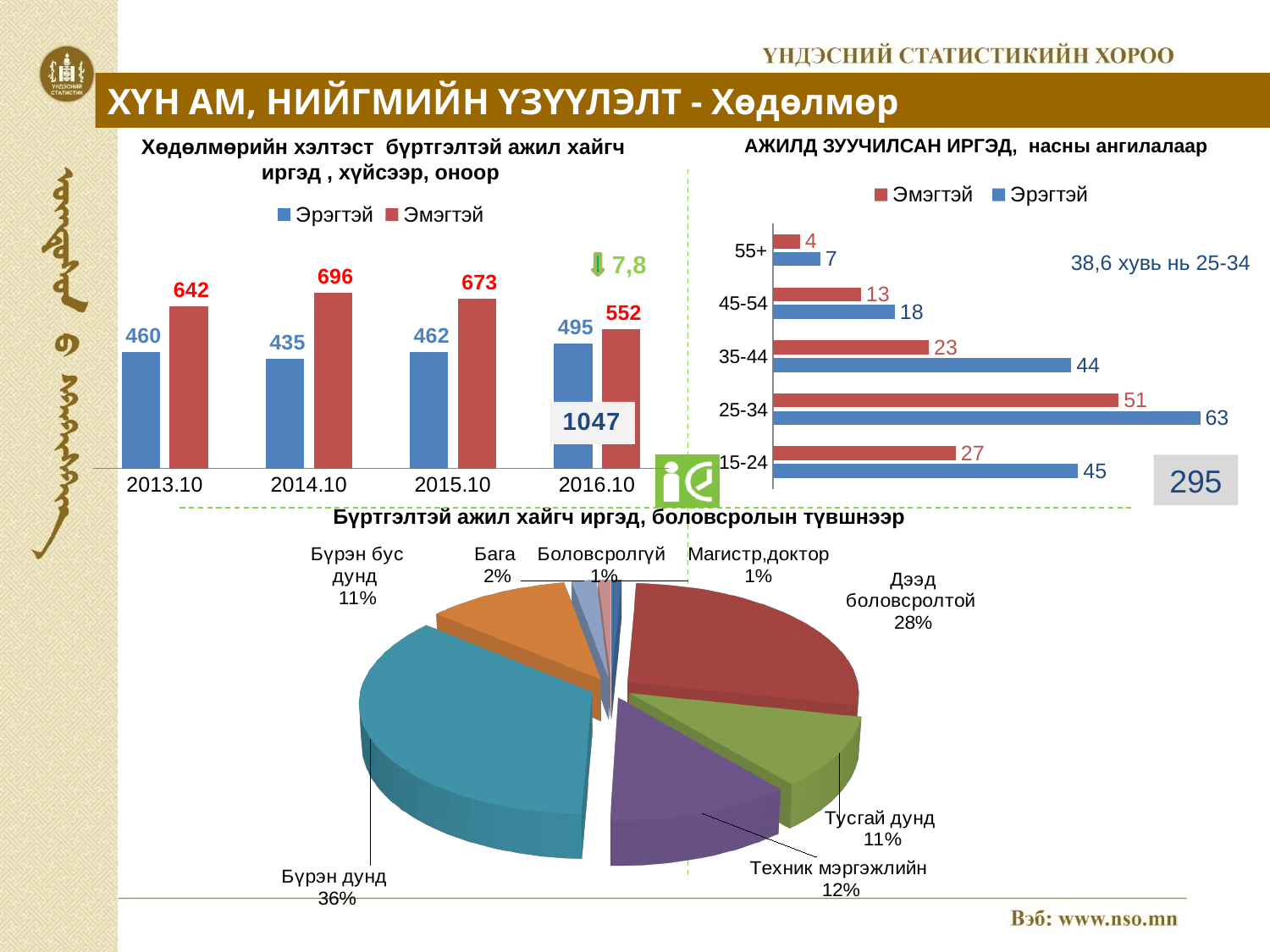
In the top-left chart 'Хөдөлмөрийн хэлтэст бүртгэлтэй ажил хайгч иргэд, хүйсээр, оноор', what is the value for Эмэгтэй in 2014.10? 696 In the top-left chart 'Хөдөлмөрийн хэлтэст бүртгэлтэй ажил хайгч иргэд, хүйсээр, оноор', in which year is the Эмэгтэй value highest? 2014.10 In the top-left chart 'Хөдөлмөрийн хэлтэст бүртгэлтэй ажил хайгч иргэд, хүйсээр, оноор', what is the difference between the Эмэгтэй and Эрэгтэй values in 2013.10? 182 In the top-right chart 'АЖИЛД ЗУУЧИЛСАН ИРГЭД, насны ангилалаар', what is the Эмэгтэй value for the 15-24 age group? 27 In the top-left chart 'Хөдөлмөрийн хэлтэст бүртгэлтэй ажил хайгч иргэд, хүйсээр, оноор', what is the value for Эрэгтэй in 2016.10? 495 In the top-right chart 'АЖИЛД ЗУУЧИЛСАН ИРГЭД, насны ангилалаар', how many series does the legend list? 2 What kind of chart is the bottom chart 'Бүртгэлтэй ажил хайгч иргэд, боловсролын түвшнээр'? Pie chart In the top-right chart 'АЖИЛД ЗУУЧИЛСАН ИРГЭД, насны ангилалаар', which is larger for the 35-44 age group, Эрэгтэй or Эмэгтэй? Эрэгтэй In the top-right chart 'АЖИЛД ЗУУЧИЛСАН ИРГЭД, насны ангилалаар', what is the Эрэгтэй value for the 25-34 age group? 63 In the bottom pie chart 'Бүртгэлтэй ажил хайгч иргэд, боловсролын түвшнээр', what share does Бүрэн дунд have? 36% In the top-left chart 'Хөдөлмөрийн хэлтэст бүртгэлтэй ажил хайгч иргэд, хүйсээр, оноор', how many years are shown on the x axis? 4 In the top-right chart 'АЖИЛД ЗУУЧИЛСАН ИРГЭД, насны ангилалаар', which age group has the lowest Эмэгтэй value? 55+